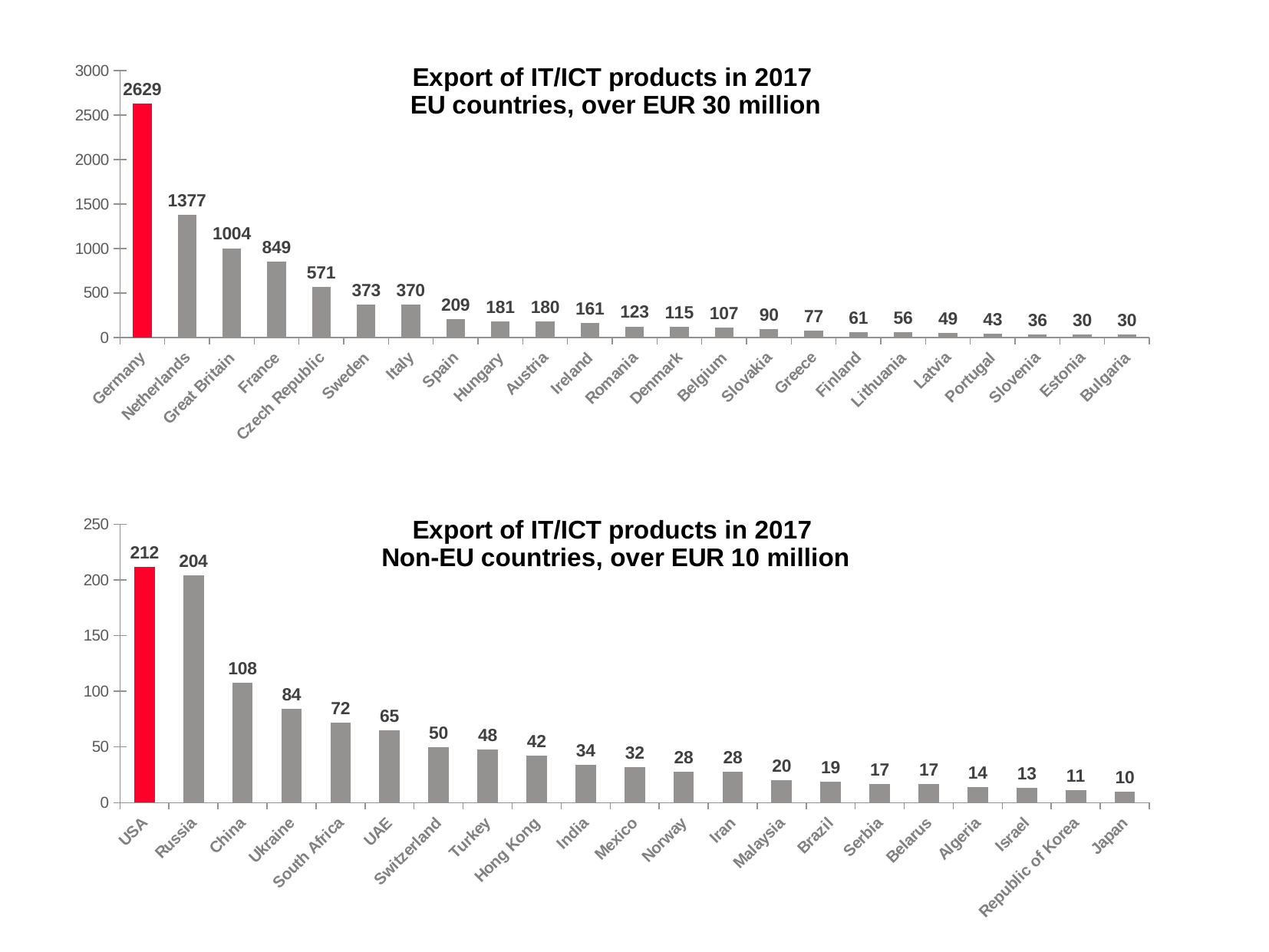
In the 'EU countries, over EUR 30 million' chart, what is the difference between Germany and Netherlands? 1252 In the 'Non-EU countries, over EUR 10 million' chart, what is the difference between USA and Russia? 8 In the 'Non-EU countries, over EUR 10 million' chart, how many countries are shown? 21 In the 'EU countries, over EUR 30 million' chart, which country has the highest value? Germany What type of chart is the 'Non-EU countries, over EUR 10 million' chart? Bar chart In the 'EU countries, over EUR 30 million' chart, what is the value for Slovakia? 90 In the 'EU countries, over EUR 30 million' chart, which is larger, Sweden or Spain? Sweden In the 'Non-EU countries, over EUR 10 million' chart, which bar is coloured red? USA In the 'Non-EU countries, over EUR 10 million' chart, what is the value for China? 108 In the 'Non-EU countries, over EUR 10 million' chart, which country has the lowest value? Japan In the 'EU countries, over EUR 30 million' chart, what is the value for France? 849 In the 'EU countries, over EUR 30 million' chart, how many countries are shown? 23